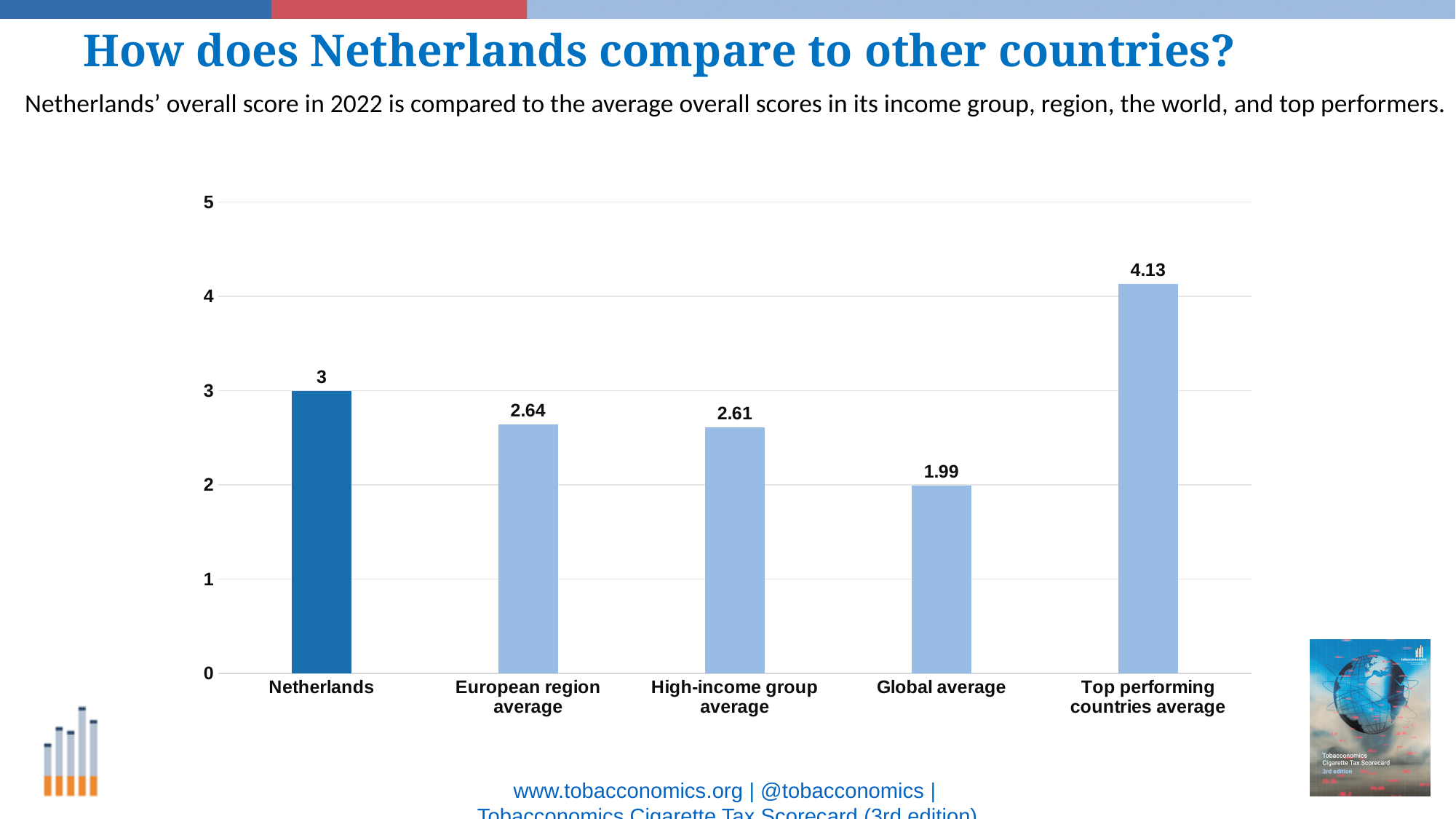
What is the difference between the Top performing countries average and the Netherlands score? 1.13 What is the overall score shown for Netherlands? 3 How many categories are shown on the chart? 5 Which is larger, the Netherlands score or the High-income group average? Netherlands What is the value shown for the European region average? 2.64 What is the value shown for the Global average? 1.99 What is the value shown for the Top performing countries average? 4.13 What kind of chart is shown on the slide? Bar chart What is the difference between the Netherlands score and the Global average? 1.01 Which category has the lowest value? Global average Is the value for the Global average greater or less than 2? less Which category has the highest value? Top performing countries average